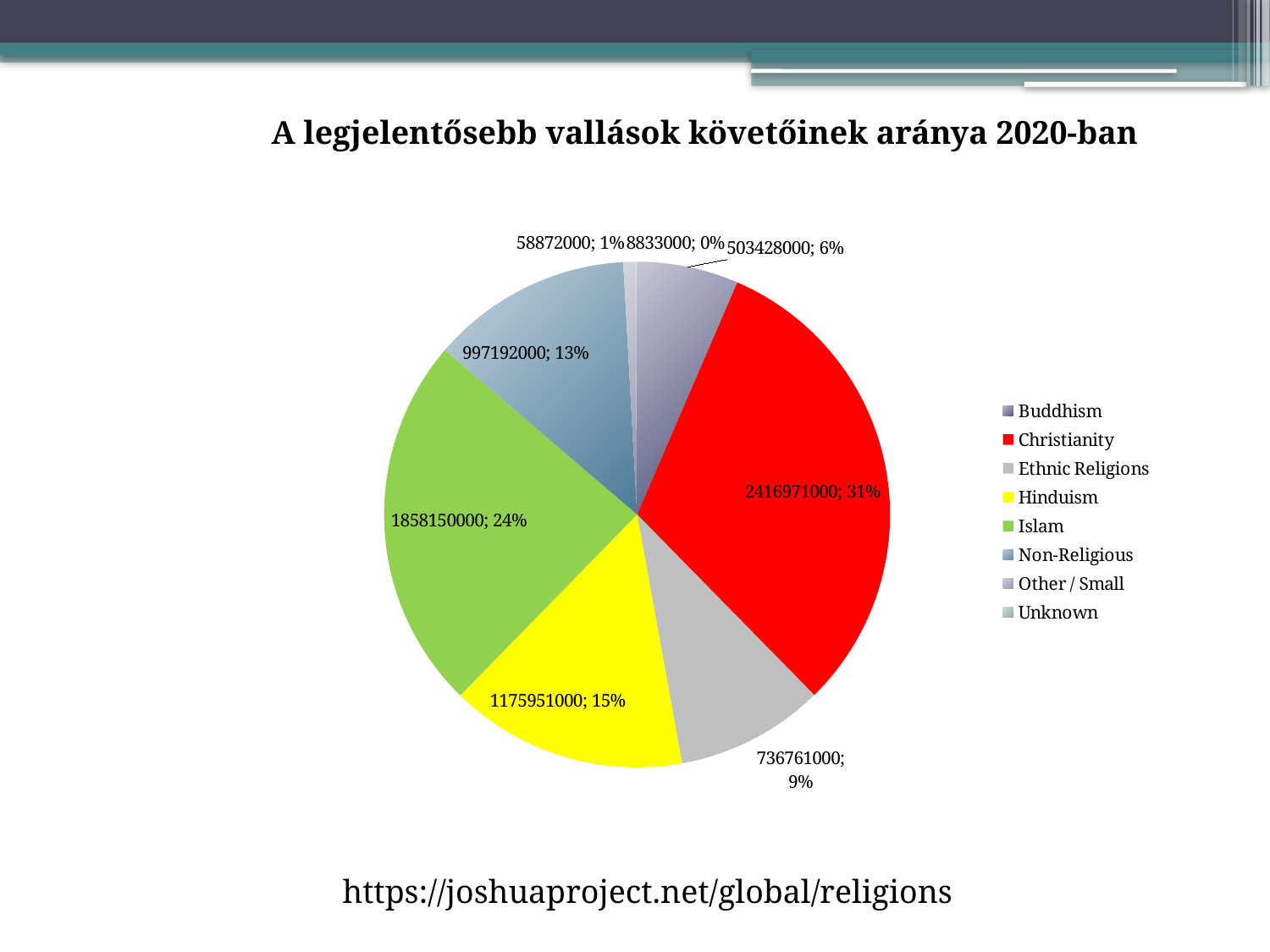
Which category has the smallest slice in the pie chart? Unknown What percentage share does Islam have in the pie chart? 24% What percentage share is shown for Non-Religious? 13% How many entries does the legend of the pie chart list? 8 Which religion has the largest slice in the pie chart? Christianity What is the value shown for Christianity in the pie chart? 2416971000 What is the value shown for Hinduism? 1175951000 What is the difference between the values for Christianity and Islam? 558821000 What kind of chart is shown on the slide? pie chart What is the title of the chart on the slide? A legjelentősebb vallások követőinek aránya 2020-ban What is the value shown for Ethnic Religions? 736761000 Which is larger, the value for Islam or the value for Hinduism? Islam